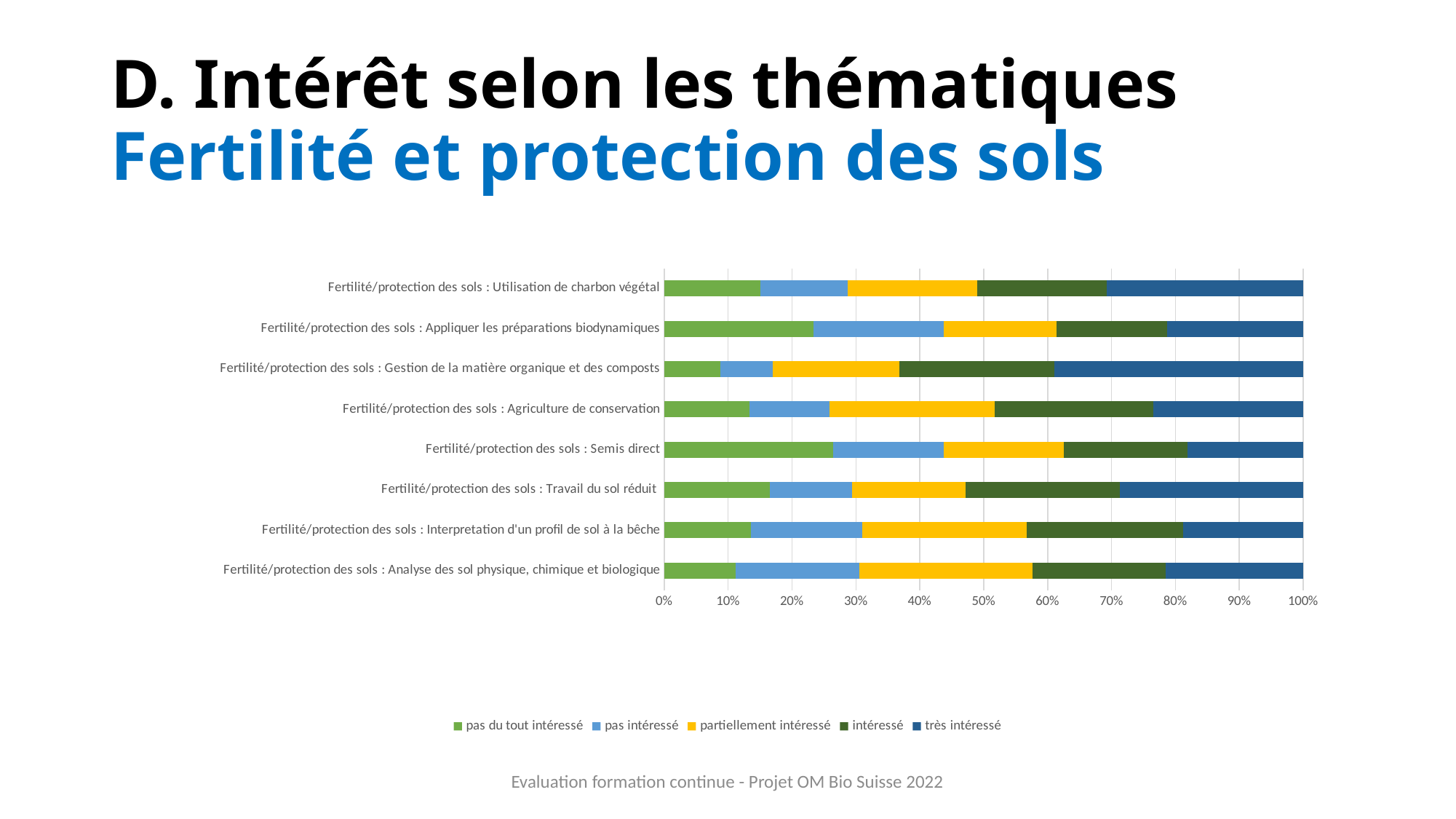
Which has the larger 'très intéressé' share: 'Gestion de la matière organique et des composts' or 'Travail du sol réduit'? Gestion de la matière organique et des composts Which series is shown in yellow in the chart legend? partiellement intéressé How many categories (thematic rows) are plotted in the chart? 8 What is the total of the stacked bar for 'Fertilité/protection des sols : Semis direct'? 100% Is the 'très intéressé' share for 'Fertilité/protection des sols : Gestion de la matière organique et des composts' greater or less than 30%? greater Is the 'pas du tout intéressé' share for 'Fertilité/protection des sols : Appliquer les préparations biodynamiques' greater or less than 20%? greater Is the 'pas du tout intéressé' share for 'Fertilité/protection des sols : Gestion de la matière organique et des composts' greater or less than 10%? less Which has the larger 'pas du tout intéressé' share: 'Semis direct' or 'Gestion de la matière organique et des composts'? Semis direct How many series does the chart legend list? 5 What kind of chart is shown on the slide? bar chart Which category has the largest 'très intéressé' segment? Fertilité/protection des sols : Gestion de la matière organique et des composts